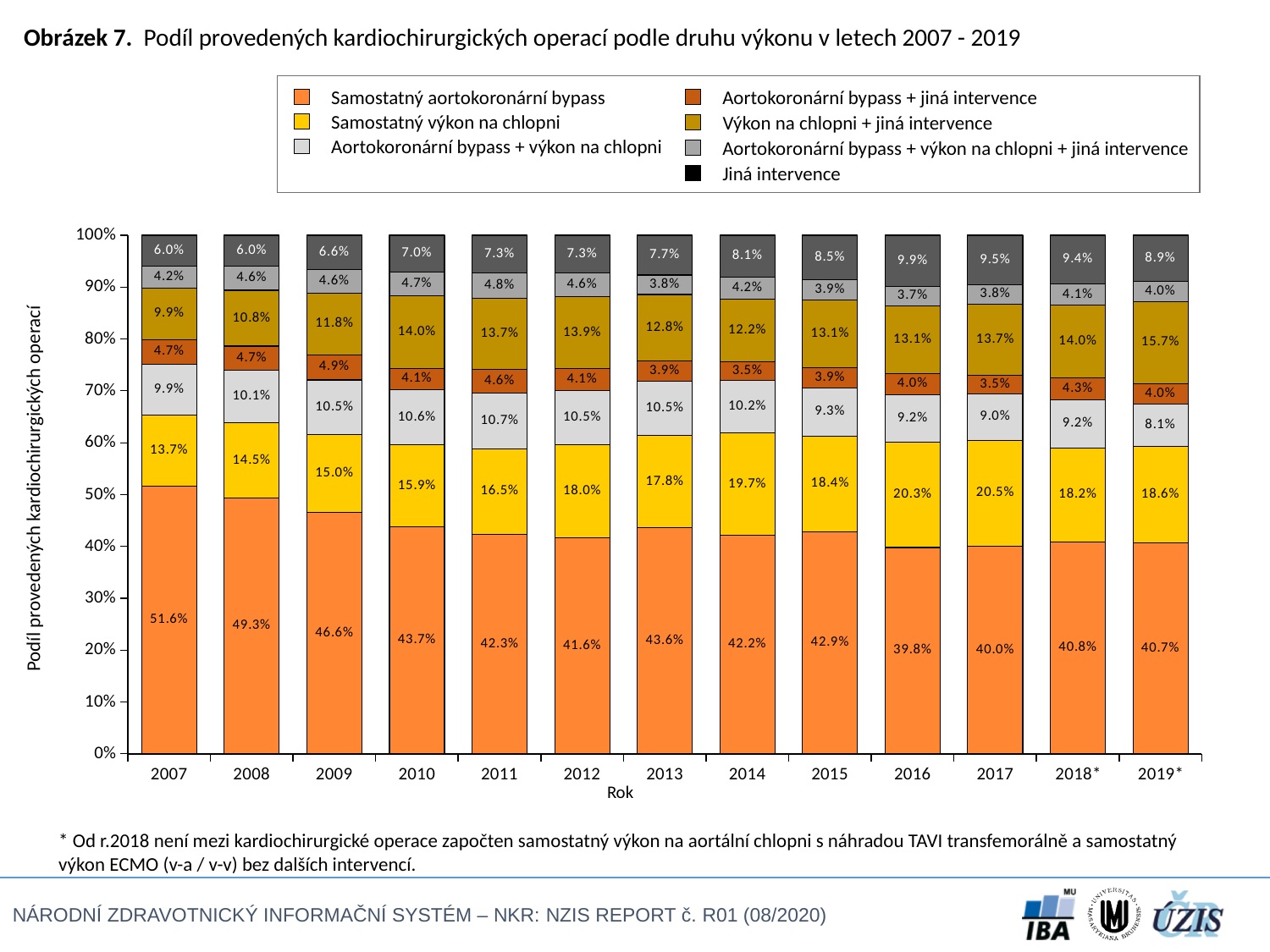
What share of operations in 2014 was Samostatný výkon na chlopni? 19.7% In which year was the share of Samostatný aortokoronární bypass highest? 2007 By how many percentage points did the share of Samostatný aortokoronární bypass fall from 2007 to 2019*? 10.9 percentage points What share of operations in 2019* was Výkon na chlopni + jiná intervence? 15.7% Which was larger in 2012: the share of Samostatný výkon na chlopni or the share of Výkon na chlopni + jiná intervence? Samostatný výkon na chlopni How many years are shown on the x axis? 13 What share of operations in 2007 was Samostatný aortokoronární bypass? 51.6% How many series does the legend list? 7 In which year was the share of Samostatný aortokoronární bypass lowest? 2016 What is the label of the y axis? Podíl provedených kardiochirurgických operací Does the share of Jiná intervence generally rise or fall from 2007 to 2016? Rise What kind of chart is shown? Stacked bar chart